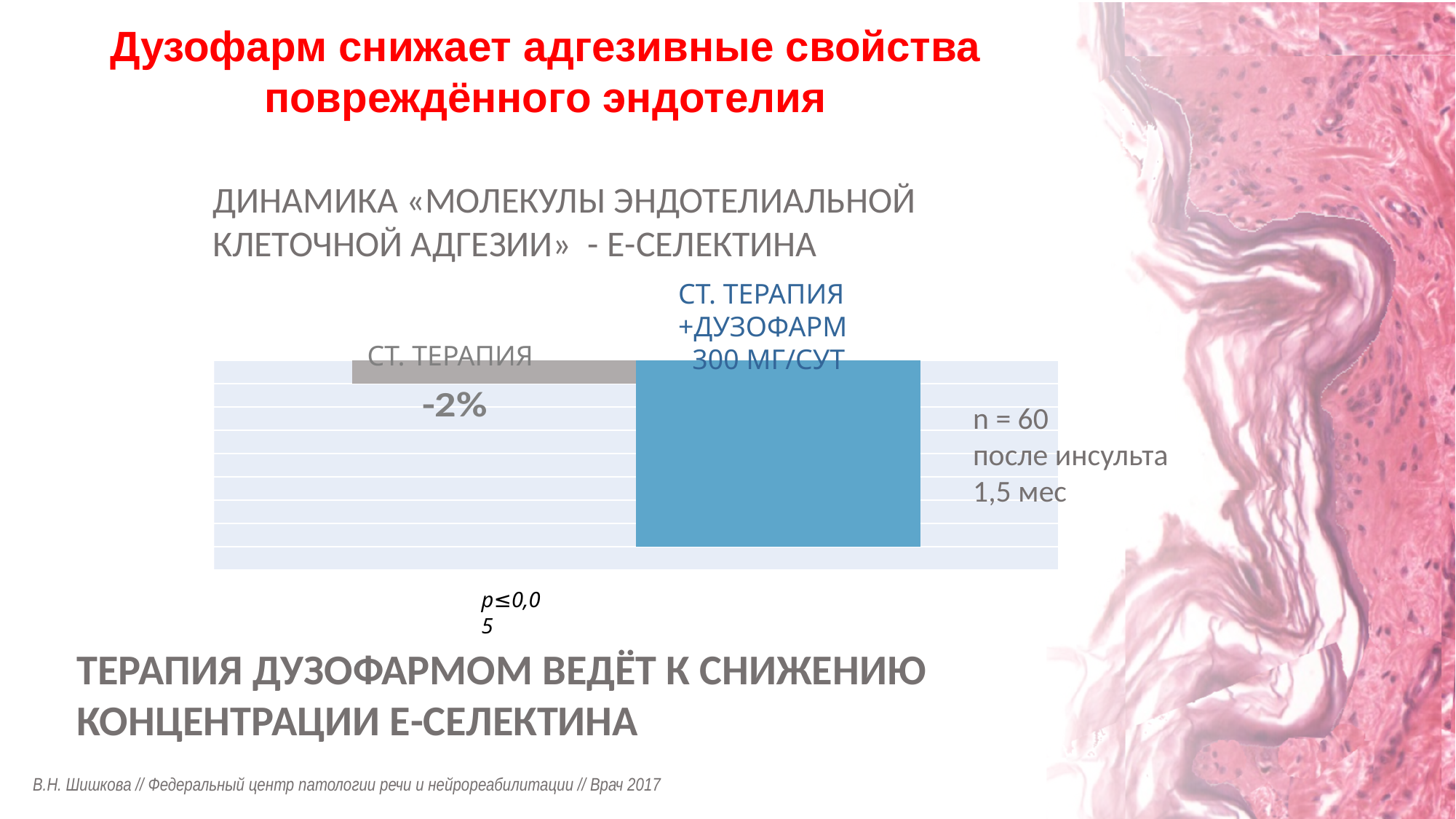
How many bars are plotted in the chart? 2 What sample size (n) is stated next to the chart? n = 60 Is the value for СТ. ТЕРАПИЯ positive or negative? negative What is the title of the chart? ДИНАМИКА «МОЛЕКУЛЫ ЭНДОТЕЛИАЛЬНОЙ КЛЕТОЧНОЙ АДГЕЗИИ» - Е-СЕЛЕКТИНА What kind of chart is shown on the slide? bar chart Which group shows the larger decrease in E-selectin: СТ. ТЕРАПИЯ or СТ. ТЕРАПИЯ +ДУЗОФАРМ 300 МГ/СУТ? СТ. ТЕРАПИЯ +ДУЗОФАРМ 300 МГ/СУТ What colour is the bar for СТ. ТЕРАПИЯ +ДУЗОФАРМ 300 МГ/СУТ? blue Which bar extends furthest below the baseline? СТ. ТЕРАПИЯ +ДУЗОФАРМ 300 МГ/СУТ What is the value shown for the СТ. ТЕРАПИЯ bar? -2% What p-value is stated below the chart? p≤0,05